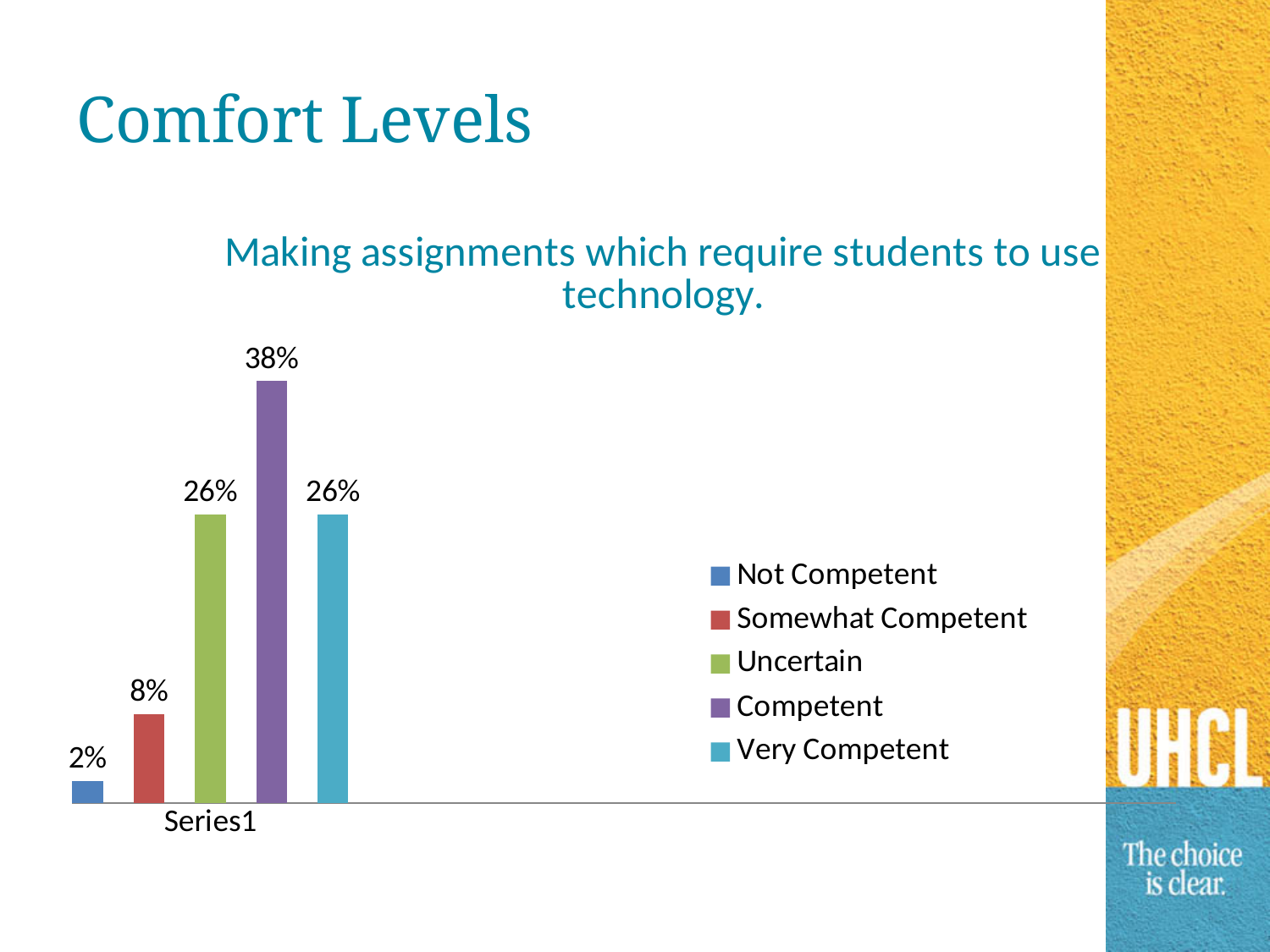
What is the value for Somewhat Competent? 8% What is the value for Not Competent? 2% Which is larger, the value for Somewhat Competent or the value for Very Competent? Very Competent Which category has the highest value? Competent How many series does the legend list? 5 What is the title of the chart? Making assignments which require students to use technology. What is the value for Competent? 38% What is the difference between the values for Competent and Uncertain? 12% Which category has the lowest value? Not Competent What is the difference between the values for Somewhat Competent and Not Competent? 6% What kind of chart is shown on the slide? Bar chart What is the value for Very Competent? 26%